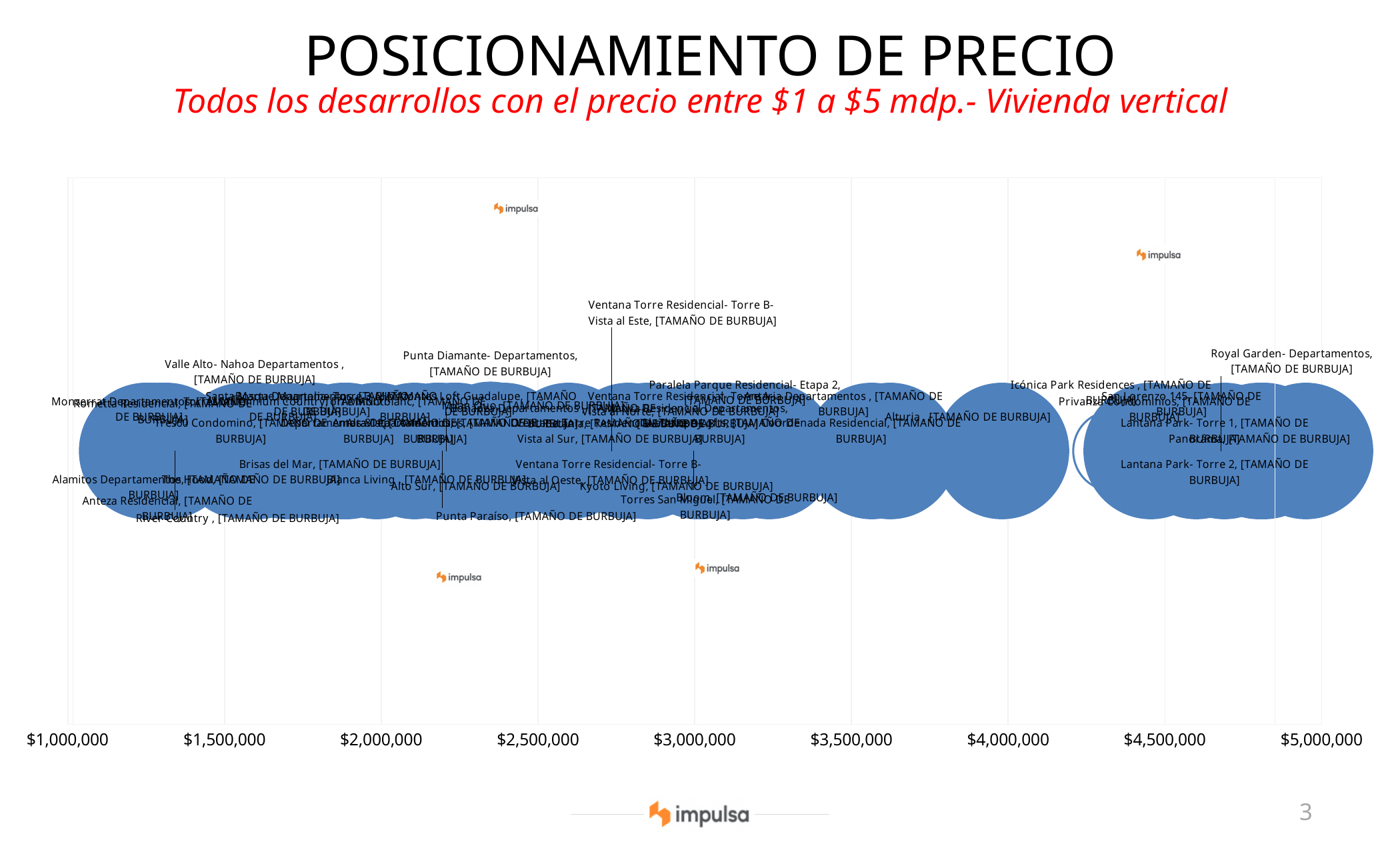
Which has the higher price value, Ventana Torre Residencial- Torre B- Vista al Este or Punta Diamante- Departamentos? Ventana Torre Residencial- Torre B- Vista al Este Is the price value for Ventana Torre Residencial- Torre B- Vista al Este greater or less than $3,000,000? less Which has the higher price value, Royal Garden- Departamentos or Alamitos Departamentos? Royal Garden- Departamentos Is the price value for Punta Diamante- Departamentos greater or less than $2,000,000? greater Is the price value for Punta Paraíso greater or less than $2,000,000? greater What kind of chart is shown on the slide? Bubble chart What are the lowest and highest values shown on the chart's horizontal axis? $1,000,000 and $5,000,000 What is the title of the slide containing the chart? POSICIONAMIENTO DE PRECIO